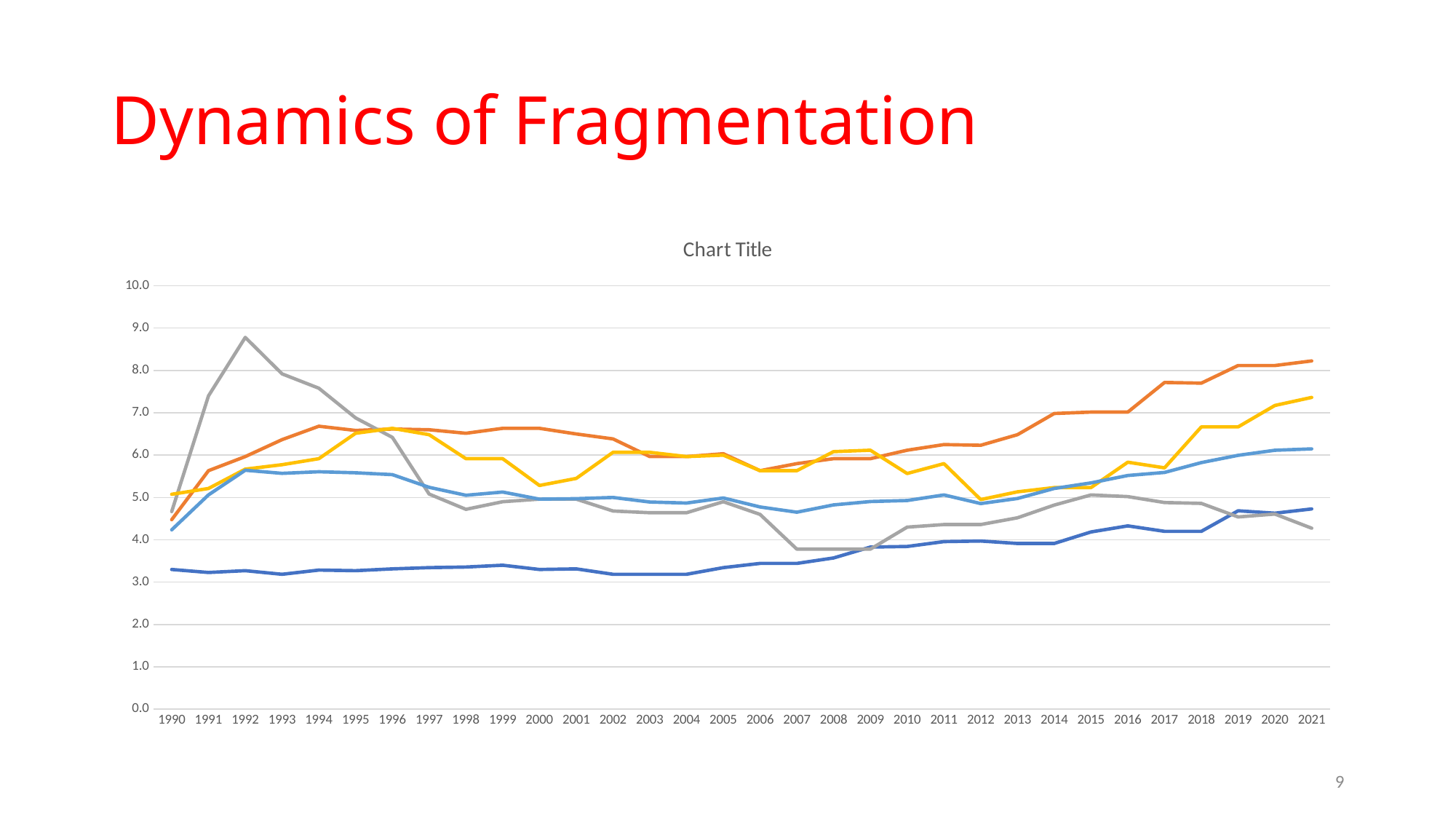
What is the first year shown on the x axis? 1990 Does the orange line generally rise or fall between 2012 and 2021? rise In 2021, is the value of the yellow line larger or smaller than the value of the grey line? larger Is the value of the dark blue line in 1990 greater or less than 4.0? less What kind of chart is shown on the slide? line chart How many lines are plotted on the chart? 5 Which line has the highest value in 2021? the orange line What is the title shown above the chart? Chart Title Is the value of the orange line in 2021 greater or less than 8.0? greater Is the value of the grey line in 1992 greater or less than 8.0? greater How many years are labelled along the x axis of the chart? 32 Which line has the lowest value in 1990? the dark blue line